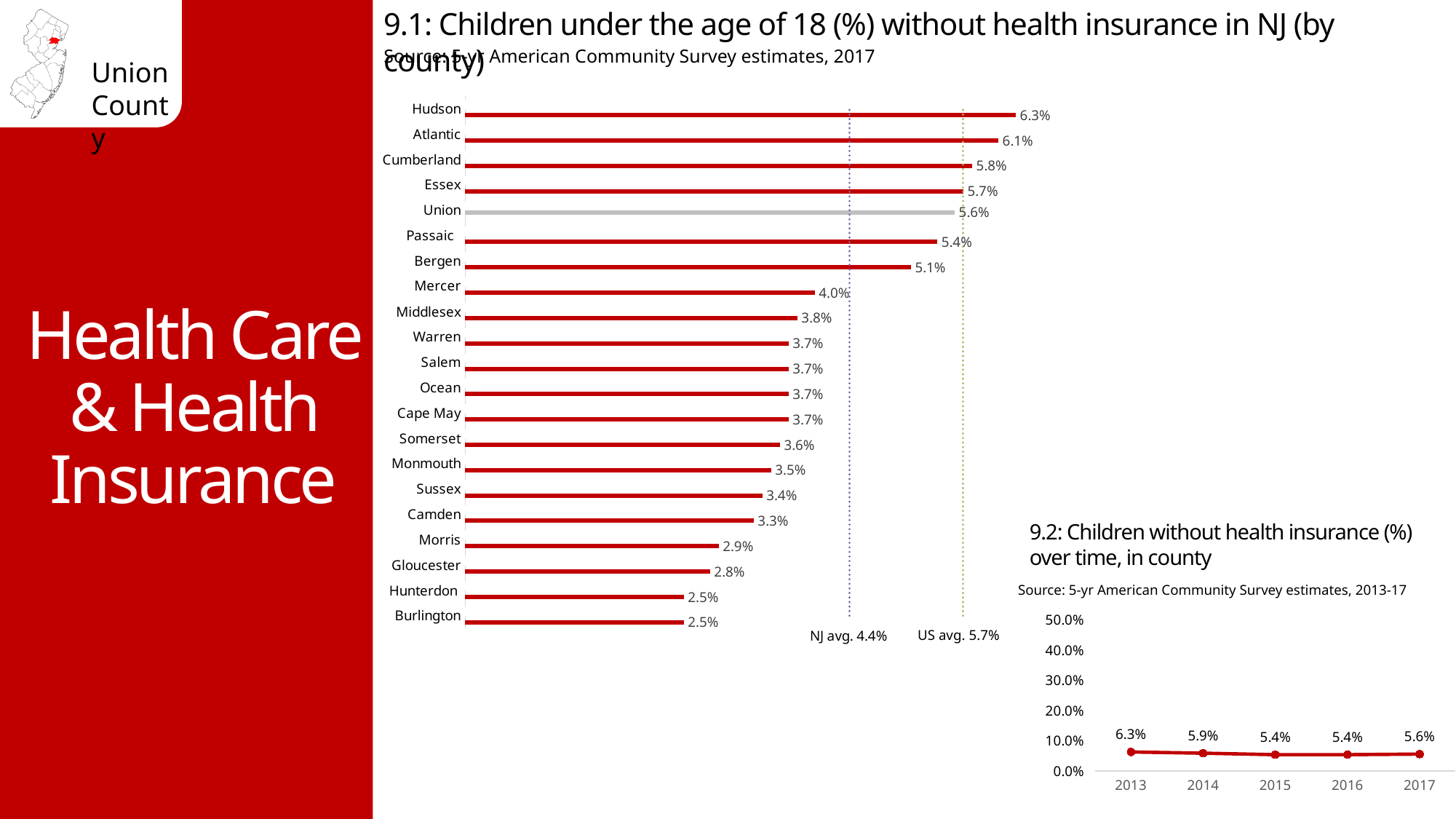
In chart 9.1, what is the difference between the values for Hudson and Union? 0.7% In chart 9.1, what is the value for Union? 5.6% What kind of chart is chart 9.1? Bar chart In chart 9.1, what is the value for Bergen? 5.1% In chart 9.1, which county has the highest value? Hudson In chart 9.1, which is larger, the value for Passaic or the value for Mercer? Passaic In chart 9.1, what NJ average value is marked by the dotted line? 4.4% In chart 9.2, how many years are plotted? 5 In chart 9.1, how many counties are plotted? 21 In chart 9.2, what is the value for 2014? 5.9% In chart 9.2, which year has the highest value? 2013 What kind of chart is chart 9.2? Line chart